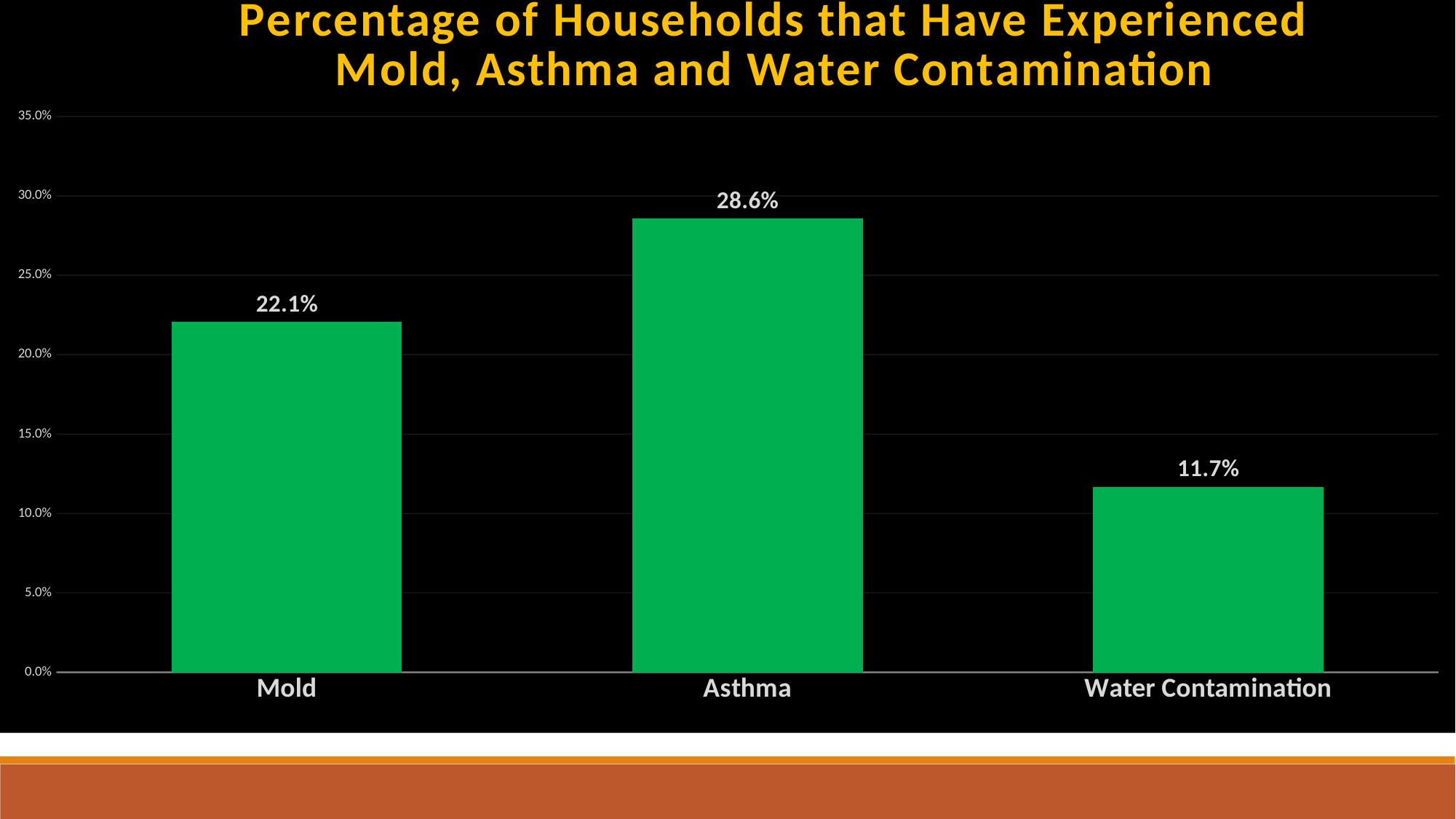
What percentage of households have experienced mold? 22.1% What is the title of the chart? Percentage of Households that Have Experienced Mold, Asthma and Water Contamination Which category has the highest percentage of households? Asthma What percentage of households have experienced asthma? 28.6% What kind of chart is shown on the slide? Bar chart What percentage of households have experienced water contamination? 11.7% Is the value for Asthma greater or less than 25.0%? greater What is the difference between the percentages for Asthma and Mold? 6.5% Which is larger, the percentage for Mold or for Water Contamination? Mold Which category has the lowest percentage of households? Water Contamination What is the difference between the percentages for Mold and Water Contamination? 10.4% How many categories are shown on the chart? 3